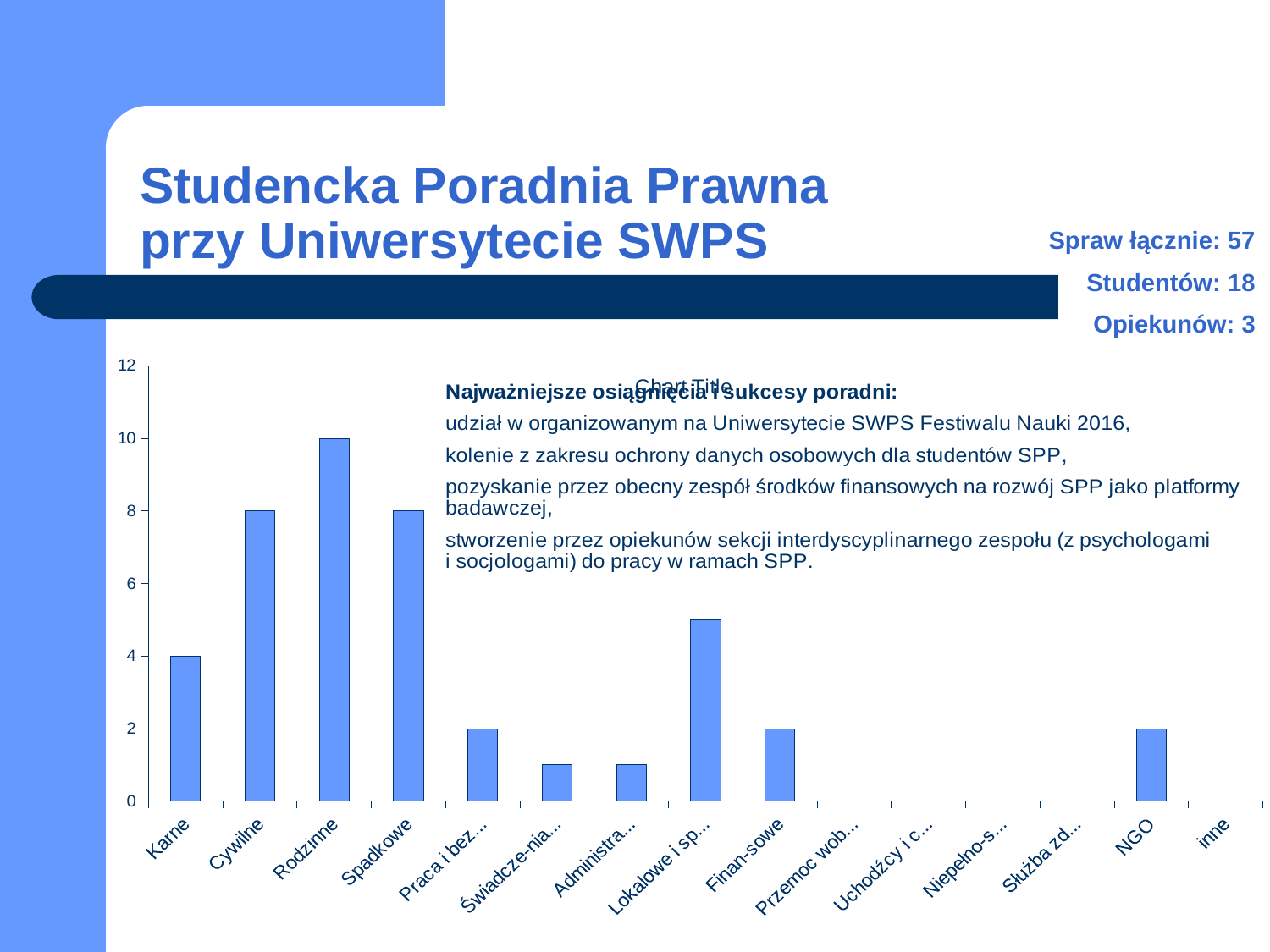
What is the value for Rodzinne? 10 How many categories are shown on the x axis of the chart? 15 What is the highest value shown on the vertical axis of the chart? 12 Is the value for Lokalowe i sp... greater or less than 4? greater What is the difference between the values for Rodzinne and Karne? 6 Which is larger, the value for Cywilne or the value for Karne? Cywilne What is the value for NGO? 2 What type of chart is shown on the slide? bar chart Which category has the highest bar in the chart? Rodzinne Is the value for Świadcze-nia... greater or less than 2? less What is the value for Karne? 4 What is the value for Cywilne? 8